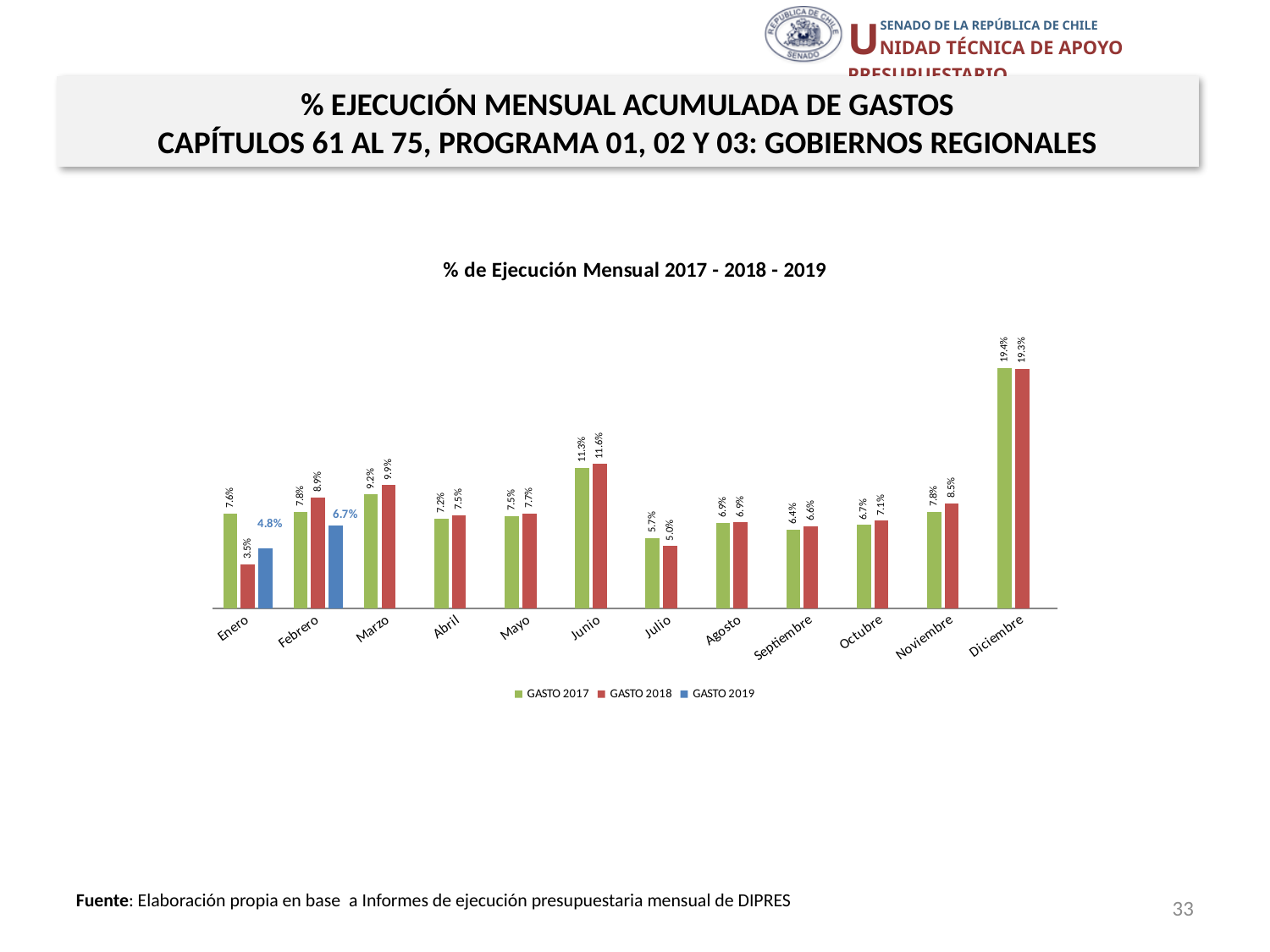
What is the value for GASTO 2019 in Febrero? 6.7% What is the value for GASTO 2019 in Enero? 4.8% Which is larger in Julio, GASTO 2017 or GASTO 2018? GASTO 2017 Which month has the highest value for GASTO 2018? Diciembre Which month has the lowest value for GASTO 2017? Julio What is the value for GASTO 2017 in Junio? 11.3% What is the title of the chart? % de Ejecución Mensual 2017 - 2018 - 2019 How many months are shown on the x axis? 12 How many series does the legend list? 3 What kind of chart is shown? Bar chart What is the difference between GASTO 2018 and GASTO 2017 in Marzo? 0.7% What is the value for GASTO 2018 in Enero? 3.5%